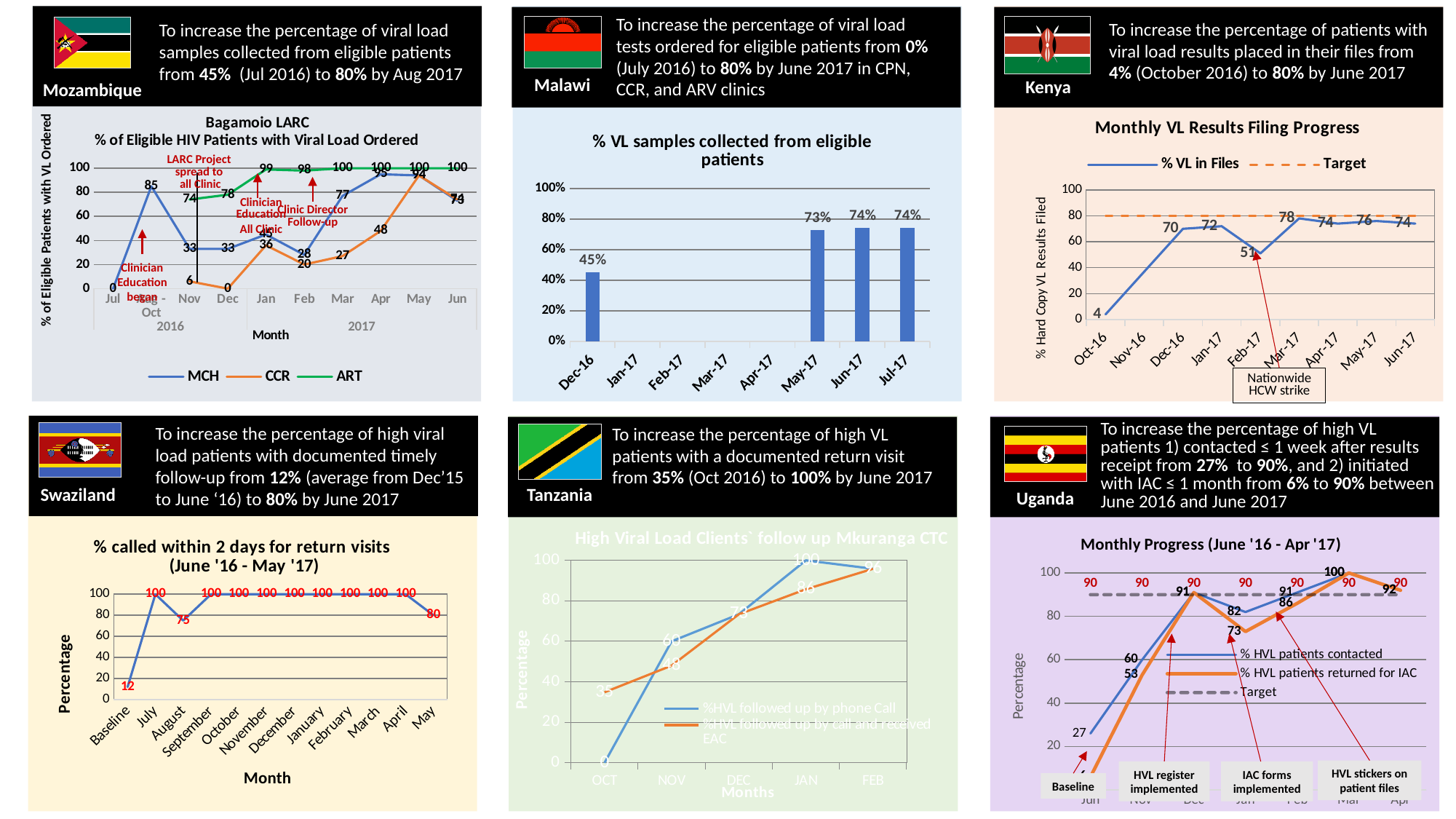
In the Swaziland chart '% called within 2 days for return visits', which category has the lowest value? Baseline How many month categories are shown on the x axis of the Malawi chart '% VL samples collected from eligible patients'? 8 What kind of chart is the Malawi chart '% VL samples collected from eligible patients'? bar chart In the Kenya chart 'Monthly VL Results Filing Progress', what is the % VL in Files value for Feb-17? 51 How many series does the legend of the Kenya chart 'Monthly VL Results Filing Progress' list? 2 In the Kenya chart 'Monthly VL Results Filing Progress', which month has the highest % VL in Files value? Mar-17 In the Malawi chart '% VL samples collected from eligible patients', what is the difference between the Jun-17 and Dec-16 values? 29% In the Malawi chart '% VL samples collected from eligible patients', what is the value for May-17? 73% In the Malawi chart '% VL samples collected from eligible patients', what is the value for Dec-16? 45% In the Uganda chart 'Monthly Progress (June '16 - Apr '17)', what is the % HVL patients contacted value for Jun? 27 In the Swaziland chart '% called within 2 days for return visits', what is the value for August? 75 How many series does the legend of the Mozambique chart 'Bagamoio LARC % of Eligible HIV Patients with Viral Load Ordered' list? 3